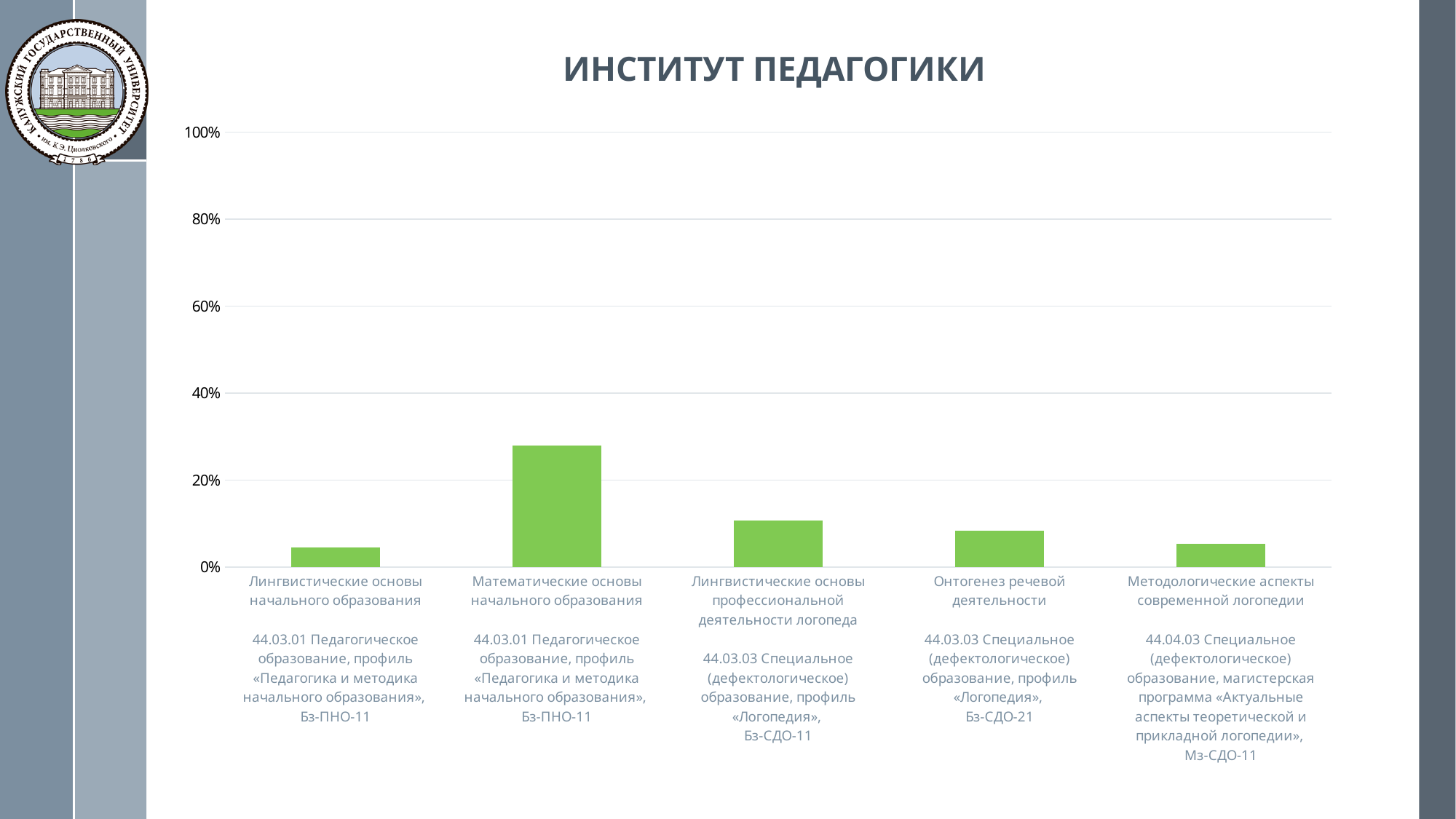
How many categories (bars) does the chart show? 5 Which is larger: the value for Лингвистические основы профессиональной деятельности логопеда (Бз-СДО-11) or for Методологические аспекты современной логопедии (Мз-СДО-11)? Лингвистические основы профессиональной деятельности логопеда (Бз-СДО-11) Is the value for Лингвистические основы профессиональной деятельности логопеда (Бз-СДО-11) greater or less than 20%? less What kind of chart is shown on the slide? bar chart Is the value for Математические основы начального образования (Бз-ПНО-11) greater or less than 40%? less Which is larger: the value for Математические основы начального образования (Бз-ПНО-11) or for Лингвистические основы профессиональной деятельности логопеда (Бз-СДО-11)? Математические основы начального образования (Бз-ПНО-11) What is the title of the chart? ИНСТИТУТ ПЕДАГОГИКИ Is the value for Математические основы начального образования (Бз-ПНО-11) greater or less than 20%? greater What colour are the bars in the chart? green Which category has the highest value? Математические основы начального образования (Бз-ПНО-11)